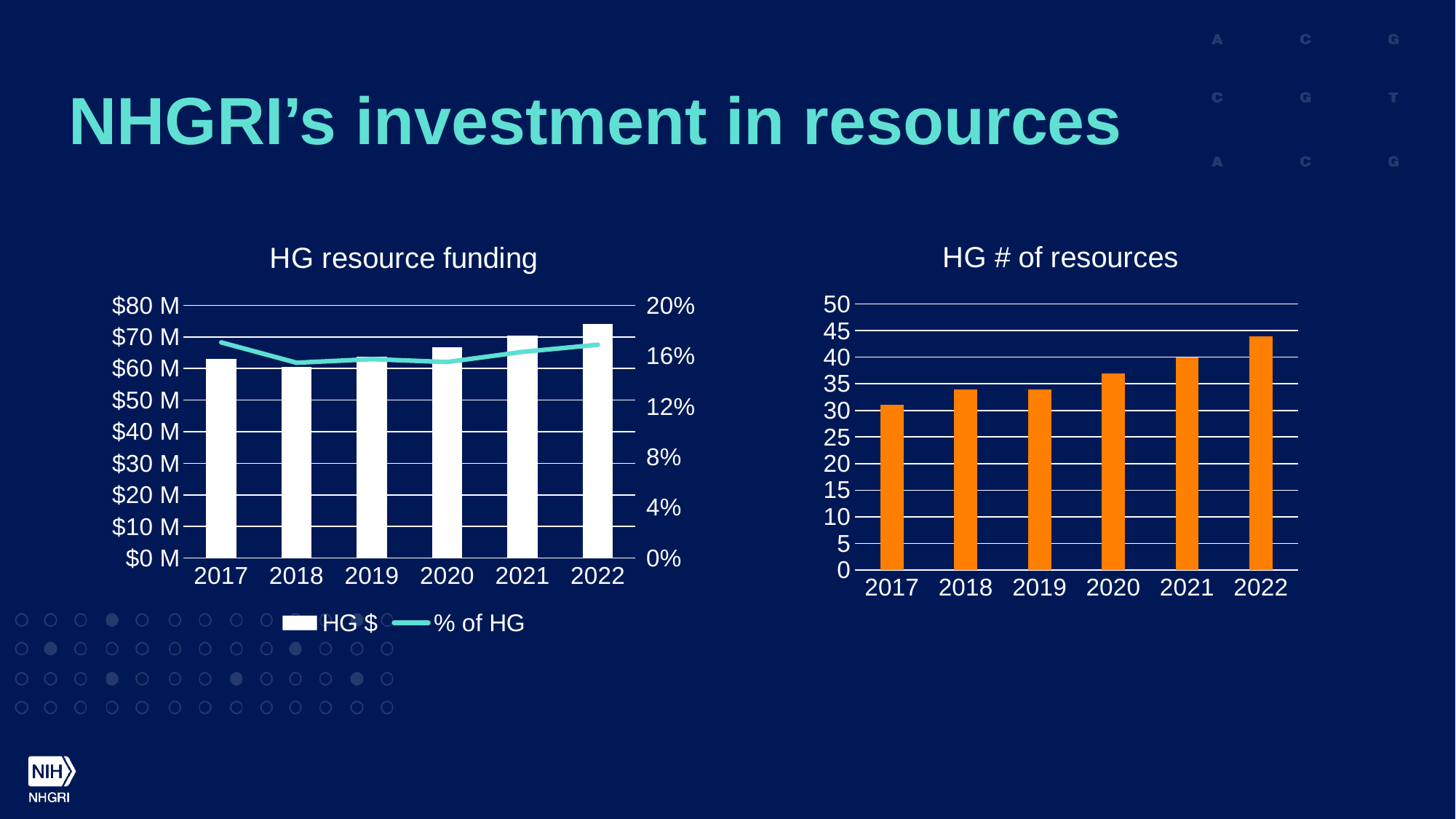
In the 'HG # of resources' chart, which year has the lowest number of resources? 2017 What kind of chart is the 'HG # of resources' chart? bar chart In the 'HG # of resources' chart, is the value for 2022 greater or less than 40? greater In the 'HG # of resources' chart, do the values generally rise or fall from 2017 to 2022? rise How many series does the legend of the 'HG resource funding' chart list? 2 In the 'HG # of resources' chart, how many years are shown on the x axis? 6 In the 'HG # of resources' chart, which year has the highest number of resources? 2022 In the 'HG resource funding' chart, is the HG $ value for 2022 greater or less than $70 M? greater In the 'HG resource funding' chart, is the HG $ value for 2017 greater or less than $70 M? less In the 'HG resource funding' chart, which year has the highest HG $ bar? 2022